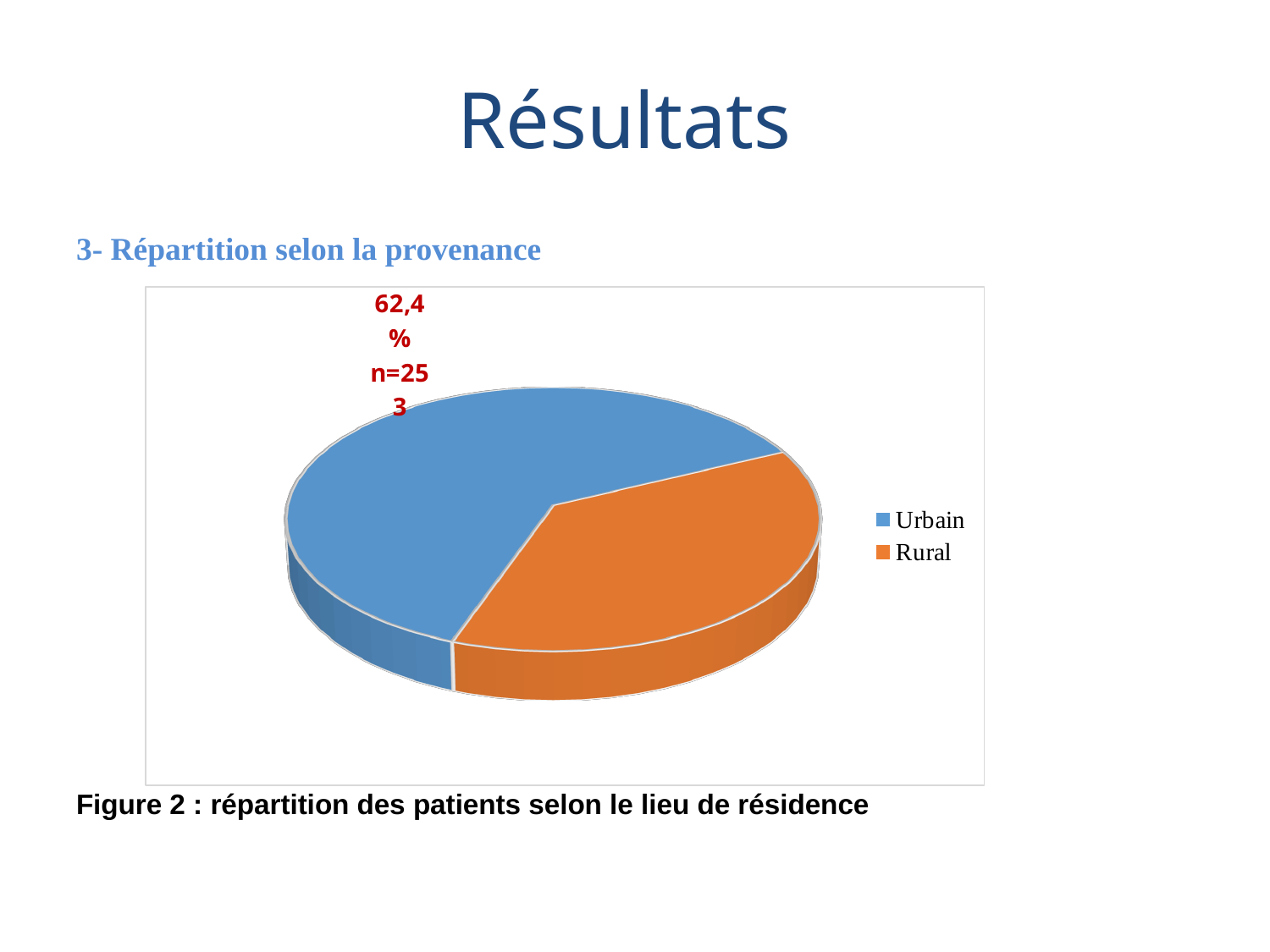
Is the share of the Urbain slice greater or less than 50%? greater What is the figure caption below the chart? Figure 2 : répartition des patients selon le lieu de résidence Which category has the smallest slice of the pie? Rural What kind of chart is shown on the slide? pie chart Which slice is larger, Urbain or Rural? Urbain What colour is the Urbain slice in the pie chart? blue What percentage is shown for the Urbain slice? 62,4 % Which category has the largest slice of the pie? Urbain How many slices does the pie chart have? 2 Is the share of the Rural slice greater or less than 50%? less What is the number of patients (n) shown for the Urbain slice? n=253 How many entries does the legend of the pie chart list? 2